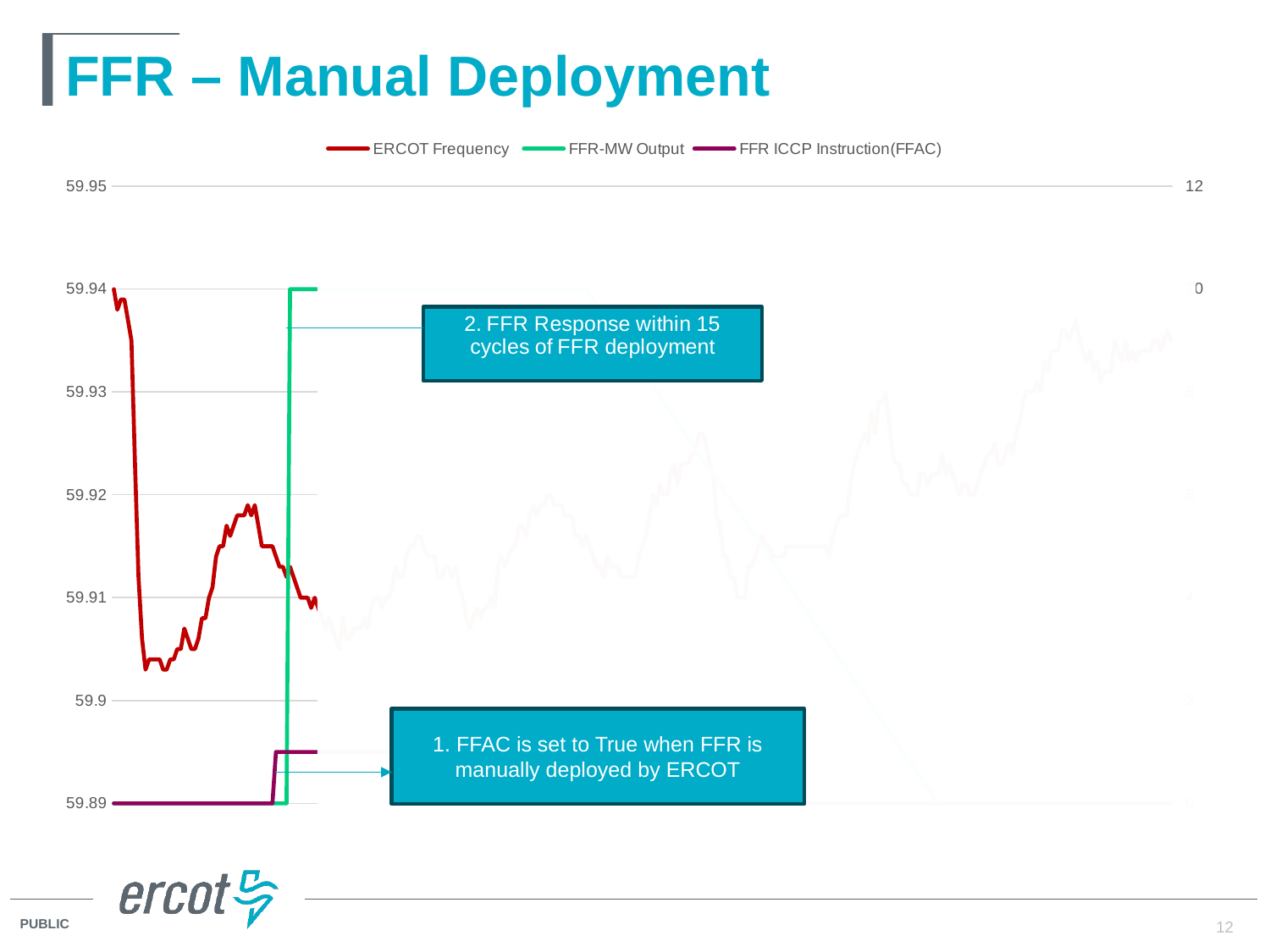
Is the lowest point of the ERCOT Frequency line greater or less than 59.91? less What are the three series named in the chart legend? ERCOT Frequency, FFR-MW Output, FFR ICCP Instruction(FFAC) What kind of chart is shown on the slide? Line chart Does the ERCOT Frequency line rise or fall at the start of the chart? fall Is the starting value of the ERCOT Frequency line greater or less than 59.93? greater How many series does the chart legend list? 3 What is the highest tick value shown on the left vertical axis of the chart? 59.95 Is the lowest point of the ERCOT Frequency line greater or less than 59.9? greater